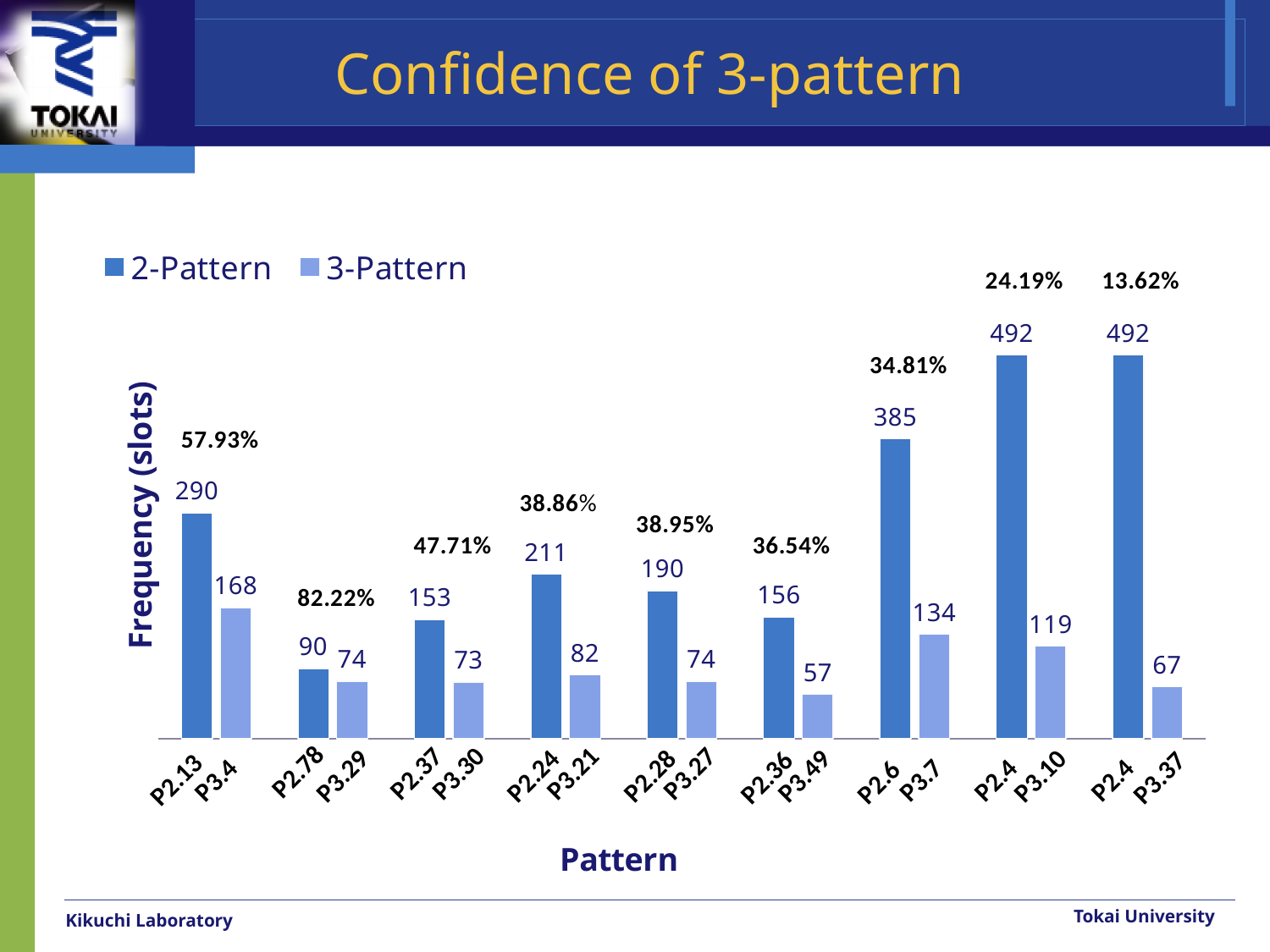
How many series does the legend list? 2 What is the 3-Pattern value for P3.7? 134 What is the 2-Pattern value for P2.13? 290 Which is larger: the 3-Pattern value for P3.21 or the 3-Pattern value for P3.49? P3.21 Which 3-Pattern bar has the highest value? P3.4 Do the confidence percentages shown above the groups rise or fall from the P2.37 / P3.30 group to the P2.4 / P3.37 group? Fall What is the title of the chart? Confidence of 3-pattern How many pattern groups (pairs of bars) are plotted on the chart? 9 What is the difference between the 2-Pattern value for P2.6 and the 3-Pattern value for P3.7? 251 What kind of chart is shown on the slide? Bar chart Which 3-Pattern bar has the lowest value? P3.37 What confidence percentage is shown above the P2.78 / P3.29 group? 82.22%